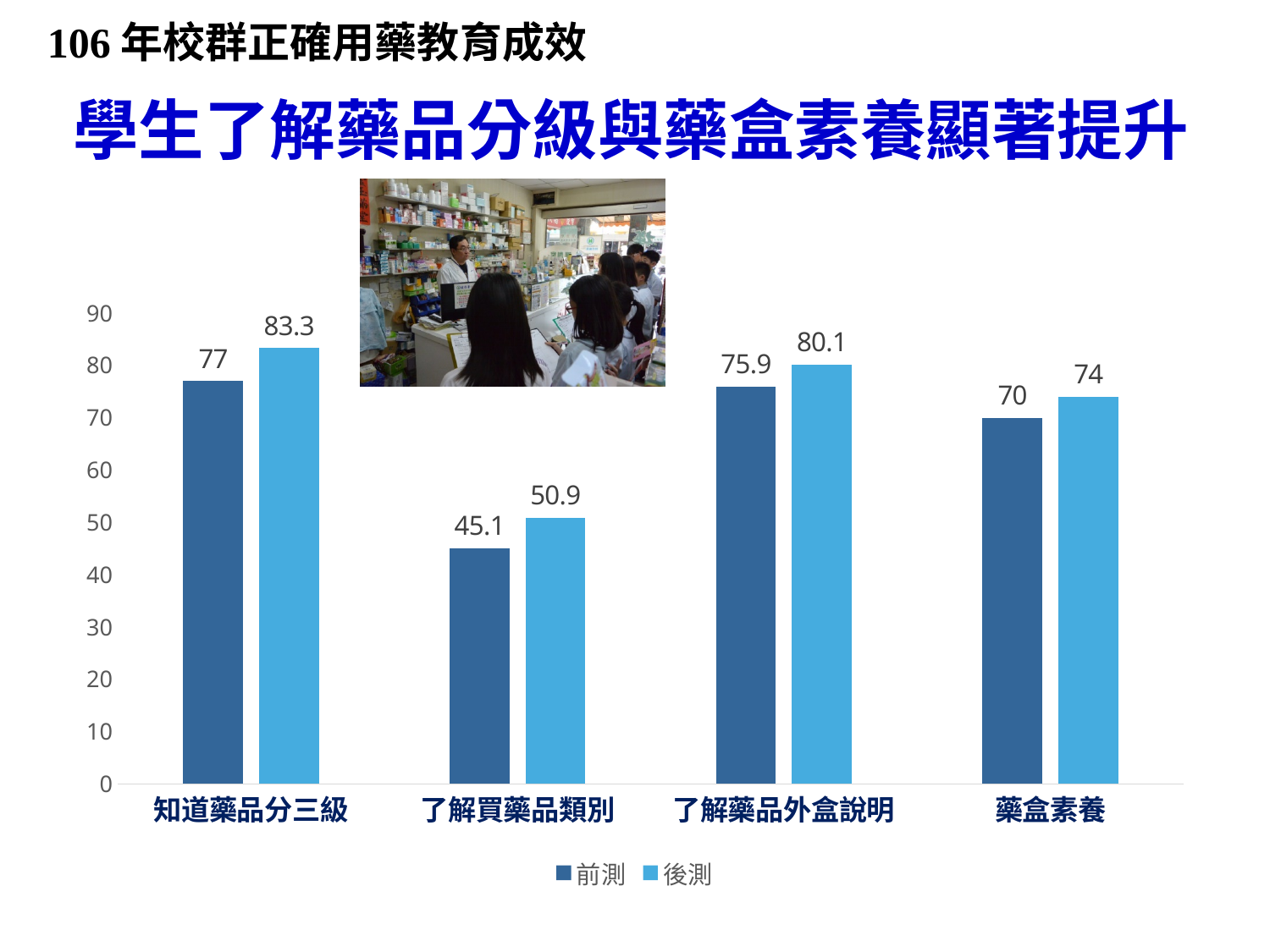
What is the 後測 value for 了解買藥品類別? 50.9 What is the difference between the 後測 and 前測 values for 知道藥品分三級? 6.3 What is the difference between the 後測 and 前測 values for 藥盒素養? 4 How many series does the legend list? 2 How many categories are shown on the x axis? 4 Which category has the highest 後測 value? 知道藥品分三級 What kind of chart is shown on the slide? bar chart Which category has the lowest 前測 value? 了解買藥品類別 What is the 後測 value for 了解藥品外盒說明? 80.1 What is the 前測 value for 藥盒素養? 70 What is the 前測 value for 知道藥品分三級? 77 Which is larger: the 前測 value for 了解藥品外盒說明 or the 前測 value for 藥盒素養? 了解藥品外盒說明